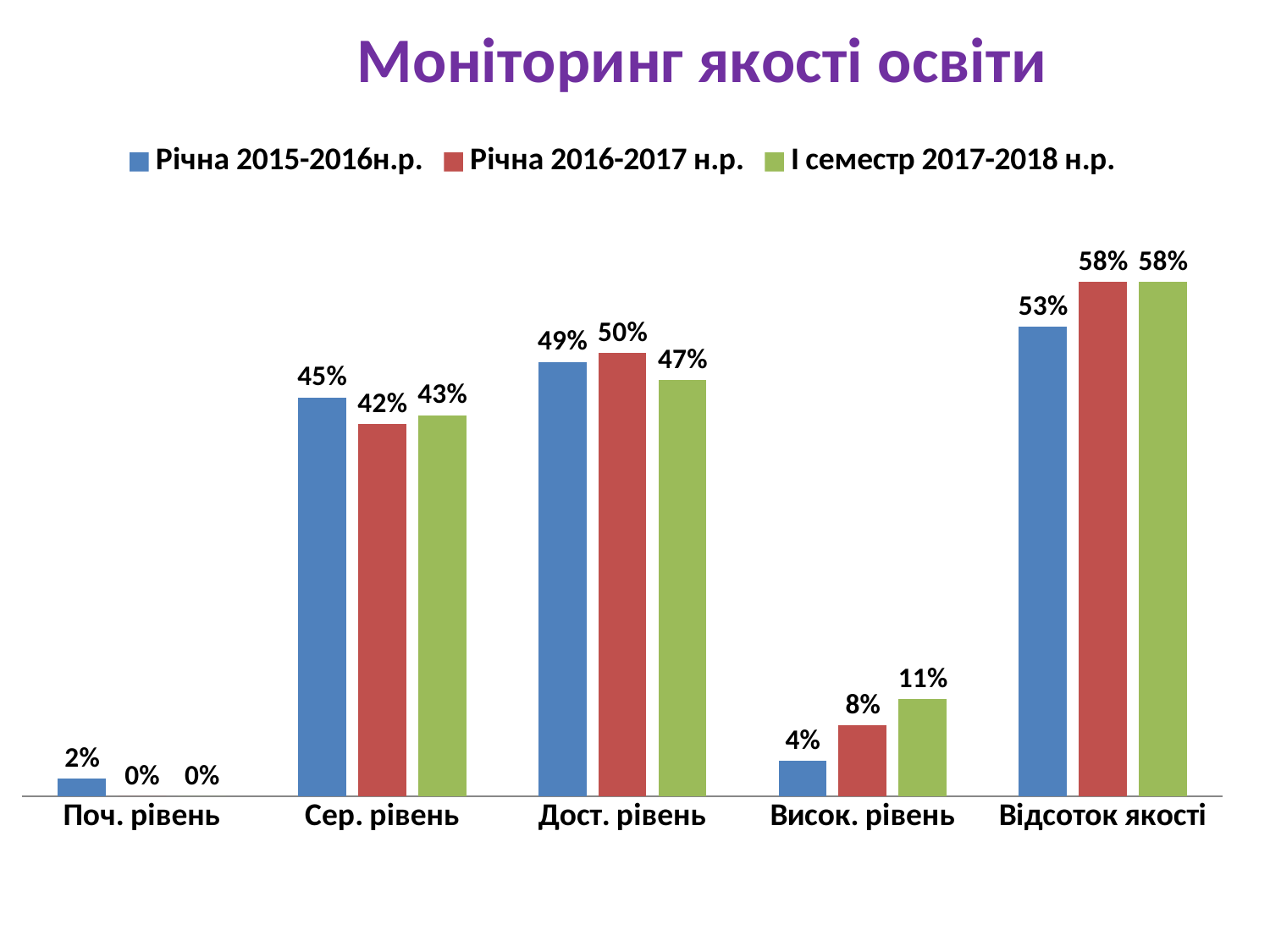
What is the difference between the Річна 2016-2017 н.р. and Річна 2015-2016н.р. values for Відсоток якості? 5% What is the value for Сер. рівень in the Річна 2015-2016н.р. series? 45% What is the value for Дост. рівень in the Річна 2016-2017 н.р. series? 50% How many categories are shown on the x axis? 5 Which category has the highest value in the Річна 2016-2017 н.р. series? Відсоток якості What is the title of the chart? Моніторинг якості освіти Do the values for Висок. рівень rise or fall from Річна 2015-2016н.р. to І семестр 2017-2018 н.р.? Rise Which is larger for Сер. рівень: the Річна 2015-2016н.р. value or the Річна 2016-2017 н.р. value? Річна 2015-2016н.р. What is the value for Висок. рівень in the І семестр 2017-2018 н.р. series? 11% How many series does the legend list? 3 Which category has the lowest value in the Річна 2015-2016н.р. series? Поч. рівень What kind of chart is shown on the slide? Bar chart